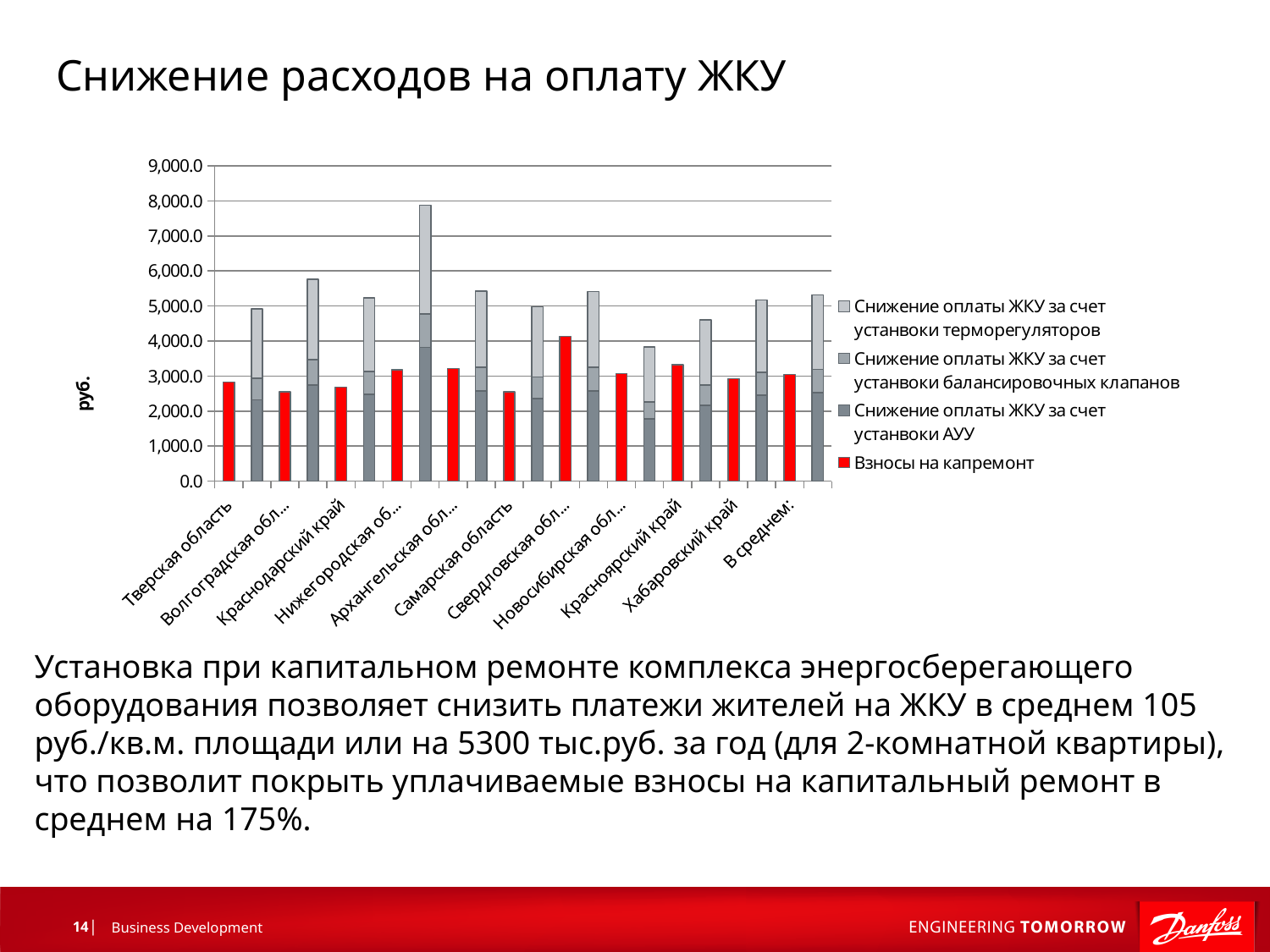
Which is larger: the stacked grey bar for Архангельская обл... or the stacked grey bar for Тверская область? Архангельская обл... Which series is shown in red in the chart legend? Взносы на капремонт How many series does the chart legend list? 4 Which category has the tallest stacked grey bar (total reduction in ЖКУ payments)? Нижегородская область Is the red bar (Взносы на капремонт) for Тверская область greater or less than 3,000.0? less Is the red bar (Взносы на капремонт) for Свердловская обл... greater or less than 4,000.0? greater What kind of chart is shown on the slide? Stacked bar chart Which category has the shortest stacked grey bar (total reduction in ЖКУ payments)? Новосибирская обл... What is the label on the vertical axis of the chart? руб. How many categories are shown along the x axis of the chart? 11 Which category has the tallest red bar (Взносы на капремонт)? Свердловская обл... Is the total of the stacked grey bar for Архангельская обл... greater or less than 7,000.0? less